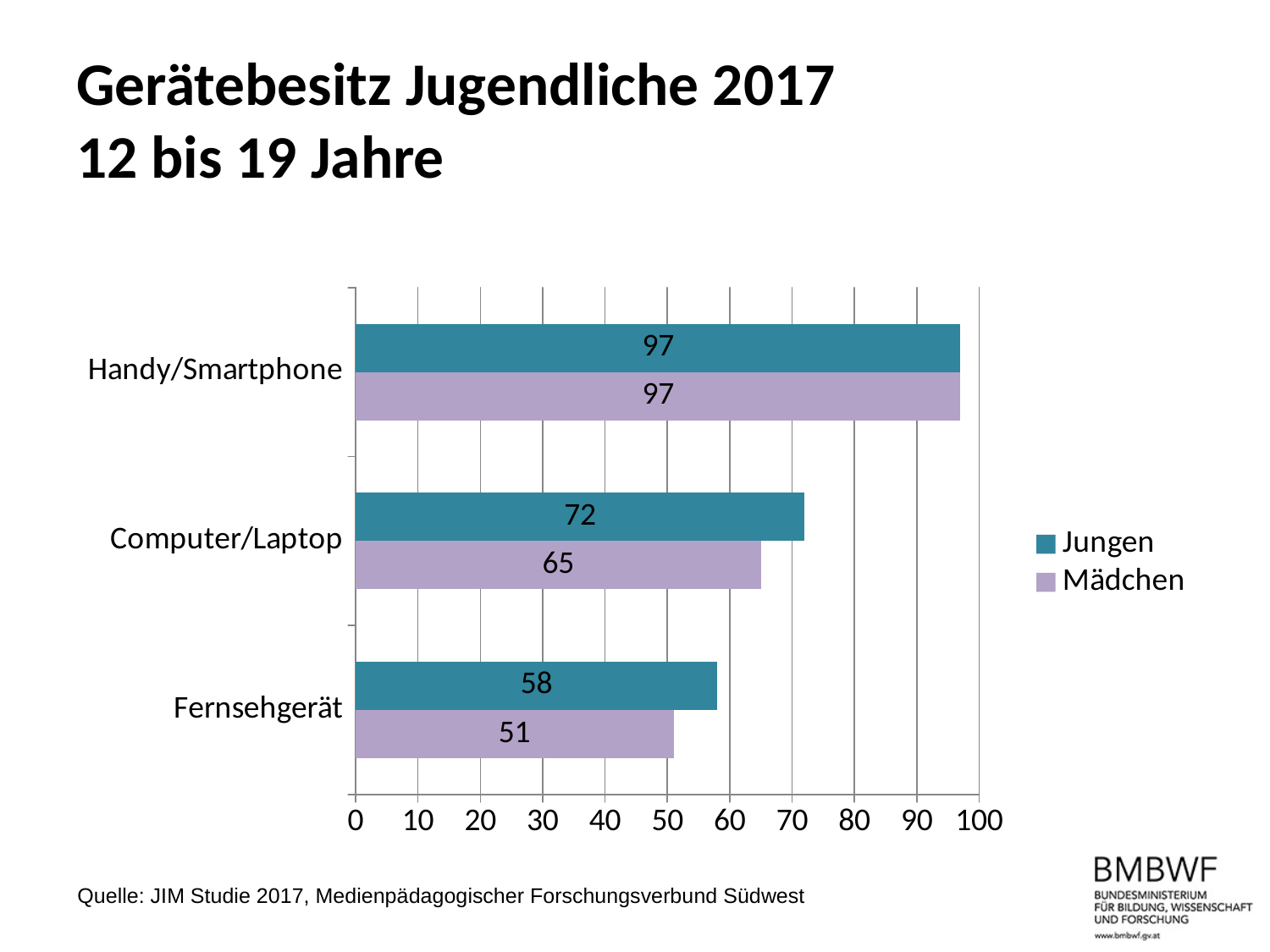
Which category has the highest value for Jungen? Handy/Smartphone Which category has the lowest value for Mädchen? Fernsehgerät What kind of chart is shown on the slide? Bar chart How many series does the legend list? 2 What is the value for Jungen for Computer/Laptop? 72 What is the difference between Jungen and Mädchen for Fernsehgerät? 7 What is the value for Mädchen for Handy/Smartphone? 97 Which is larger for Fernsehgerät, the value for Jungen or for Mädchen? Jungen What is the difference between Jungen and Mädchen for Computer/Laptop? 7 Which series is shown in purple? Mädchen What is the value for Mädchen for Fernsehgerät? 51 How many categories are shown on the chart? 3